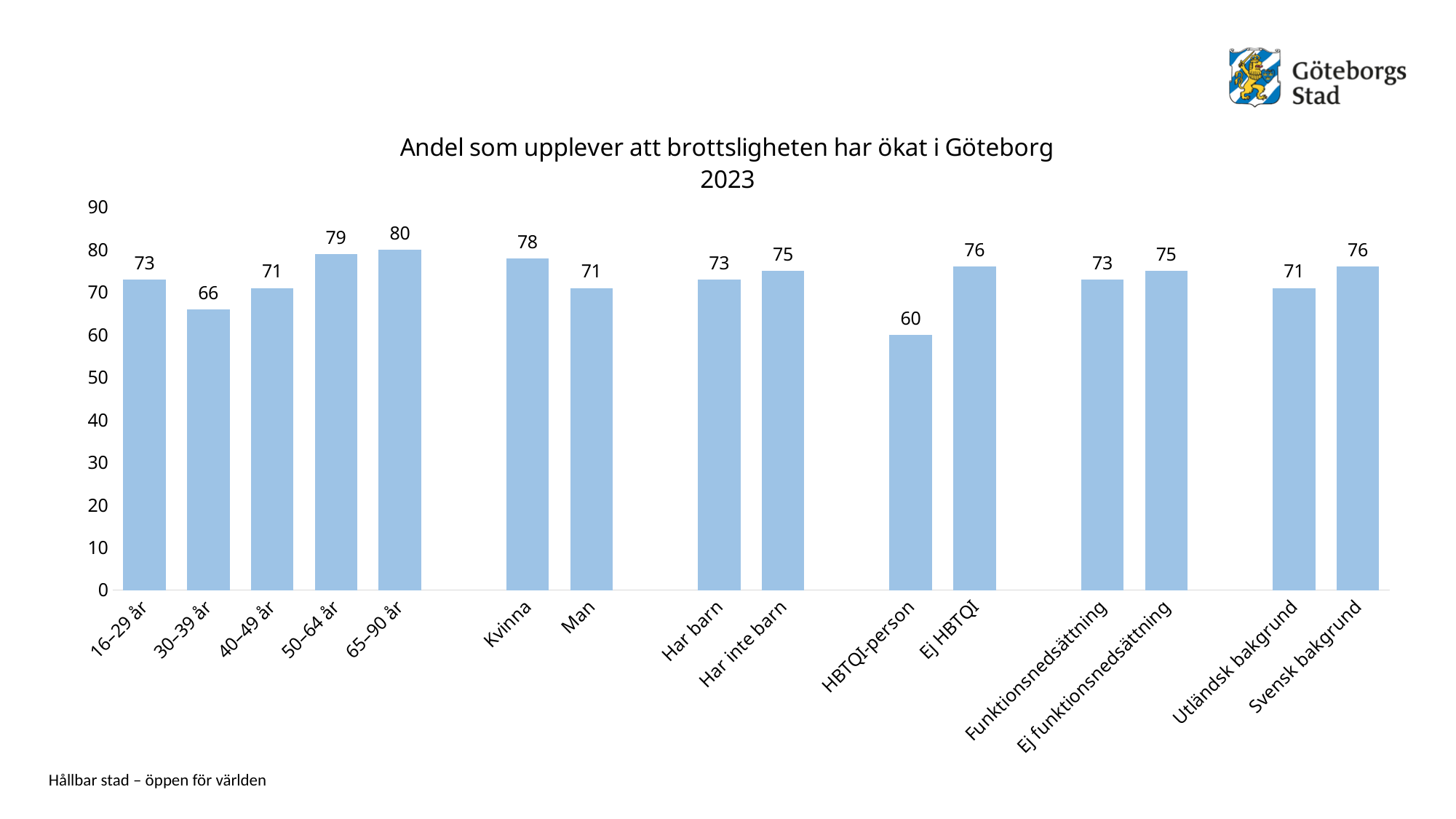
Which category has the highest value? 65–90 år How many categories are shown on the x axis? 15 What is the difference between the values for Ej HBTQI and HBTQI-person? 16 Do the values rise or fall across the age groups from 30–39 år to 65–90 år? Rise Which category has the lowest value? HBTQI-person What is the value for Kvinna? 78 What is the value for HBTQI-person? 60 What is the title of the chart? Andel som upplever att brottsligheten har ökat i Göteborg 2023 What kind of chart is this? Bar chart Which is larger, the value for Kvinna or the value for Man? Kvinna What is the difference between the values for Svensk bakgrund and Utländsk bakgrund? 5 What is the value for 65–90 år? 80